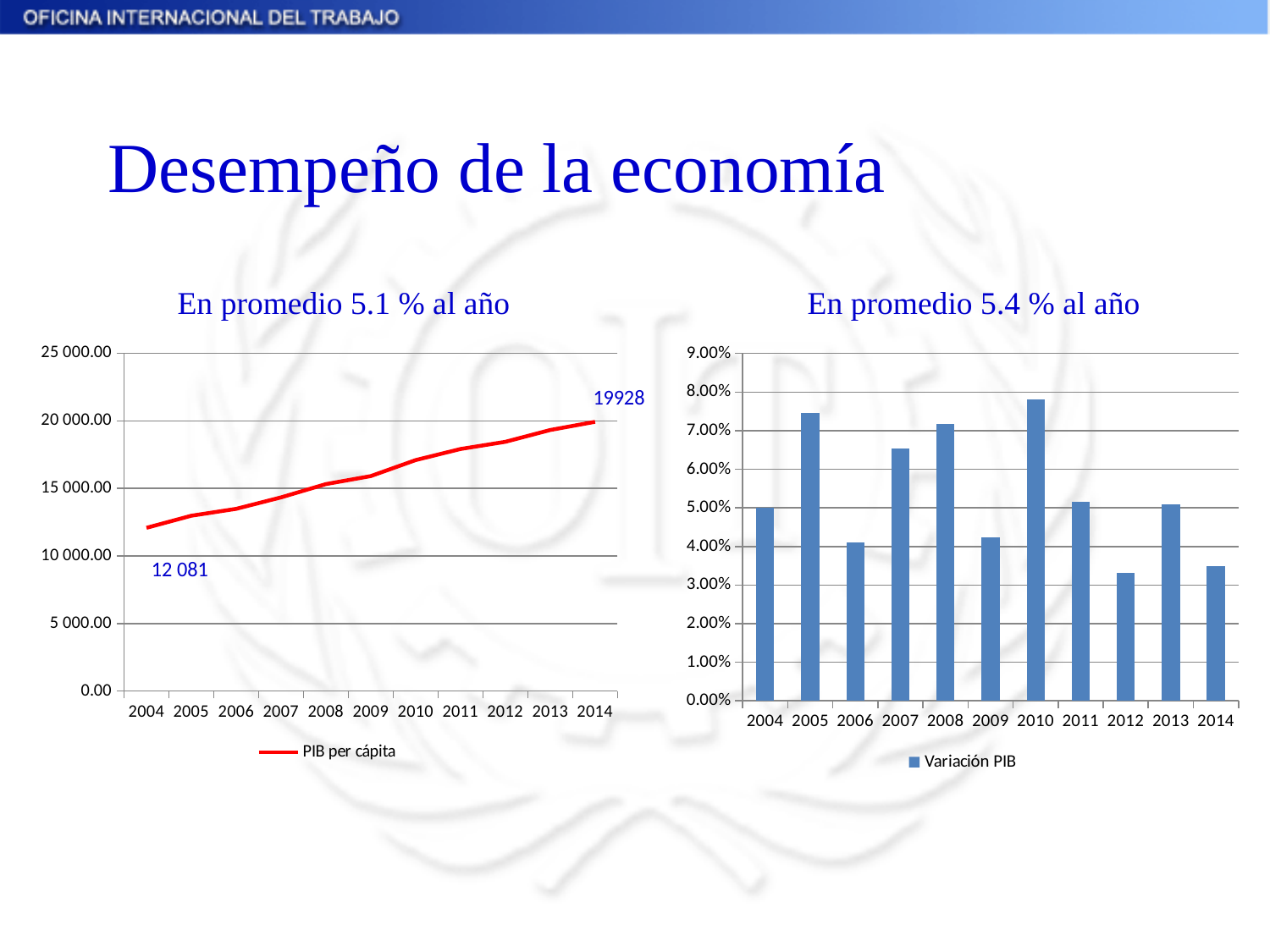
In the left chart (PIB per cápita), is the value for 2010 greater or less than 15 000.00? greater In the left chart (PIB per cápita), is the value for 2006 greater or less than 15 000.00? less In the left chart (PIB per cápita), what is the difference between the 2014 value and the 2004 value? 7847 In the right chart (Variación PIB), is the value for 2012 greater or less than 4.00%? less In the left chart (PIB per cápita), what is the value for 2014? 19928 In the left chart (PIB per cápita), what is the value for 2004? 12 081 In the right chart (Variación PIB), which year has the highest value? 2010 What kind of chart is the left chart (PIB per cápita)? line chart How many years are shown on the x axis of the right chart (Variación PIB)? 11 In the right chart (Variación PIB), which is larger, the value for 2005 or the value for 2006? 2005 In the left chart (PIB per cápita), do the values rise or fall from 2004 to 2014? rise